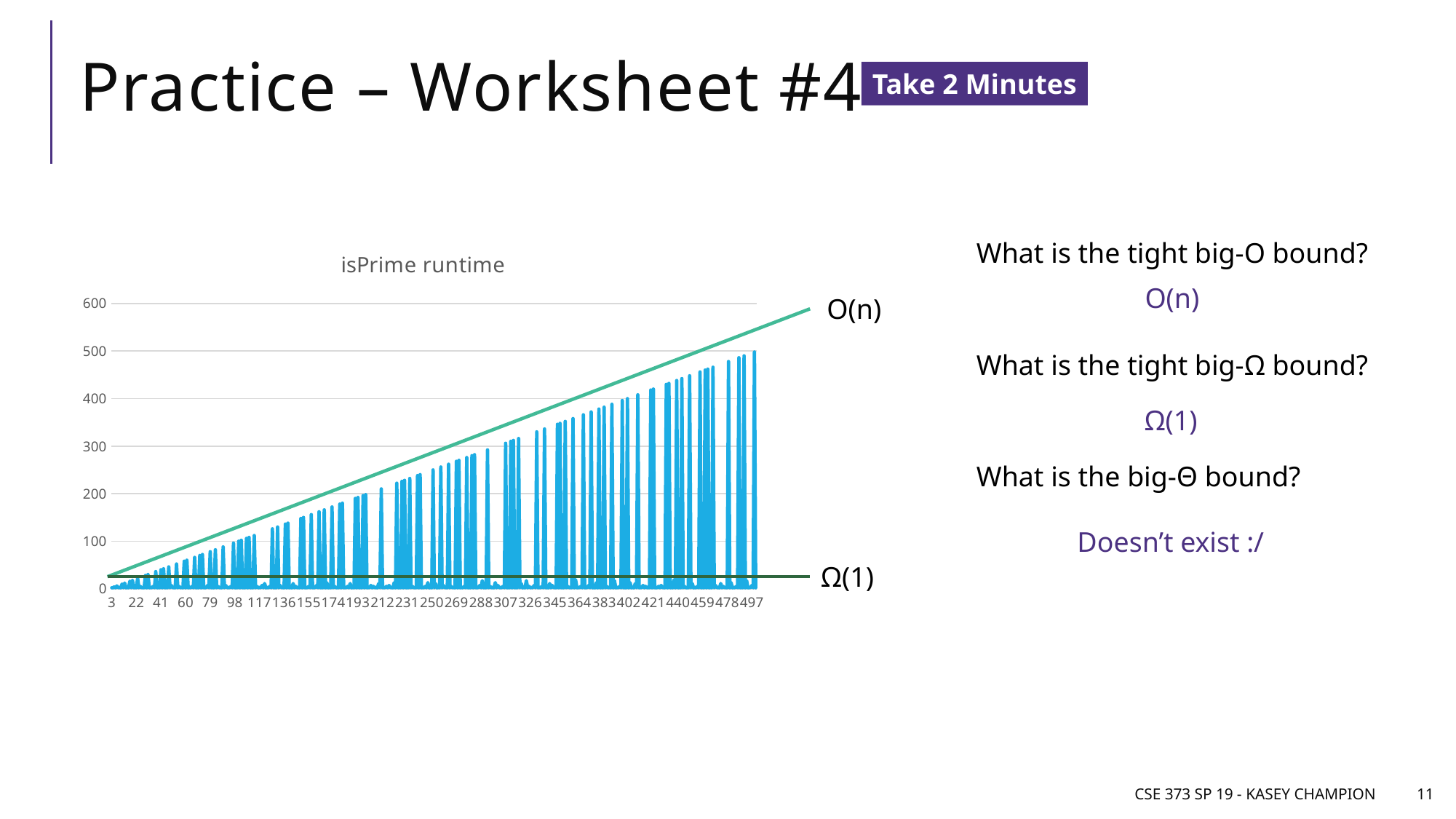
What is the last label shown on the x axis of the chart? 497 Is the highest runtime value plotted on the chart greater or less than 400? greater Is the runtime value at the first x-axis label (3) greater or less than 100? less What labels are attached to the two straight bounding lines drawn on the chart? O(n) and Ω(1) What kind of chart is the isPrime runtime chart? line chart Is the highest runtime value plotted on the chart greater or less than 600? less Do the peak runtime values rise or fall as the input size increases along the x axis? rise What is the title of the chart? isPrime runtime